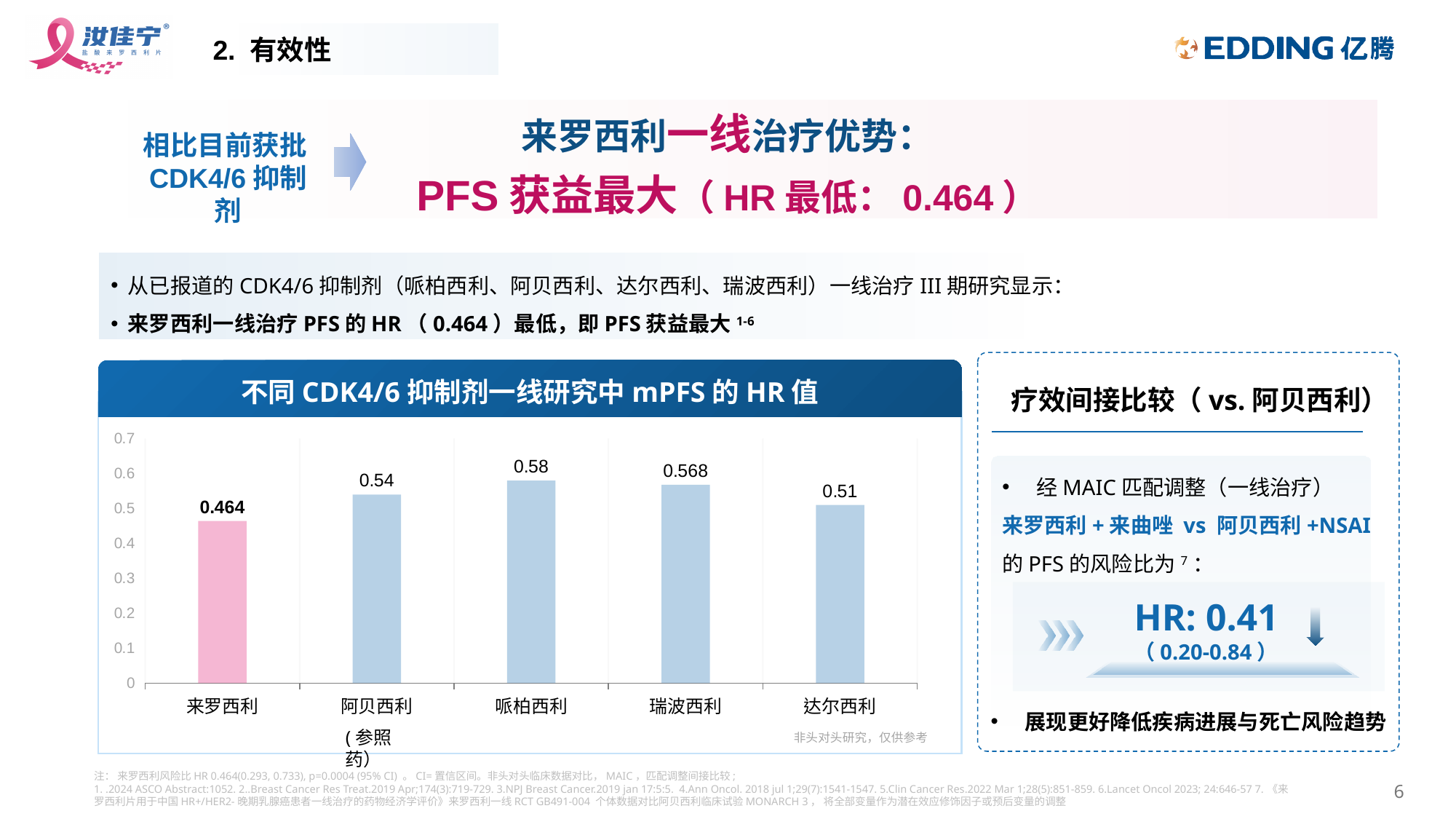
What is the HR value shown for 哌柏西利? 0.58 Is the HR value for 来罗西利 greater or less than 0.5? less What is the HR value shown for 达尔西利? 0.51 How many CDK4/6 inhibitors are plotted in the chart? 5 What is the HR value shown for 瑞波西利? 0.568 What type of chart is used to show the mPFS HR values? bar chart Which has a larger HR value, 阿贝西利 or 达尔西利? 阿贝西利 What is the HR value shown for 来罗西利 in the chart? 0.464 What is the title of the chart? 不同 CDK4/6 抑制剂一线研究中 mPFS 的 HR 值 Which CDK4/6 inhibitor has the highest HR value in the chart? 哌柏西利 Which CDK4/6 inhibitor has the lowest HR value in the chart? 来罗西利 What is the difference between the HR values of 阿贝西利 and 来罗西利? 0.076